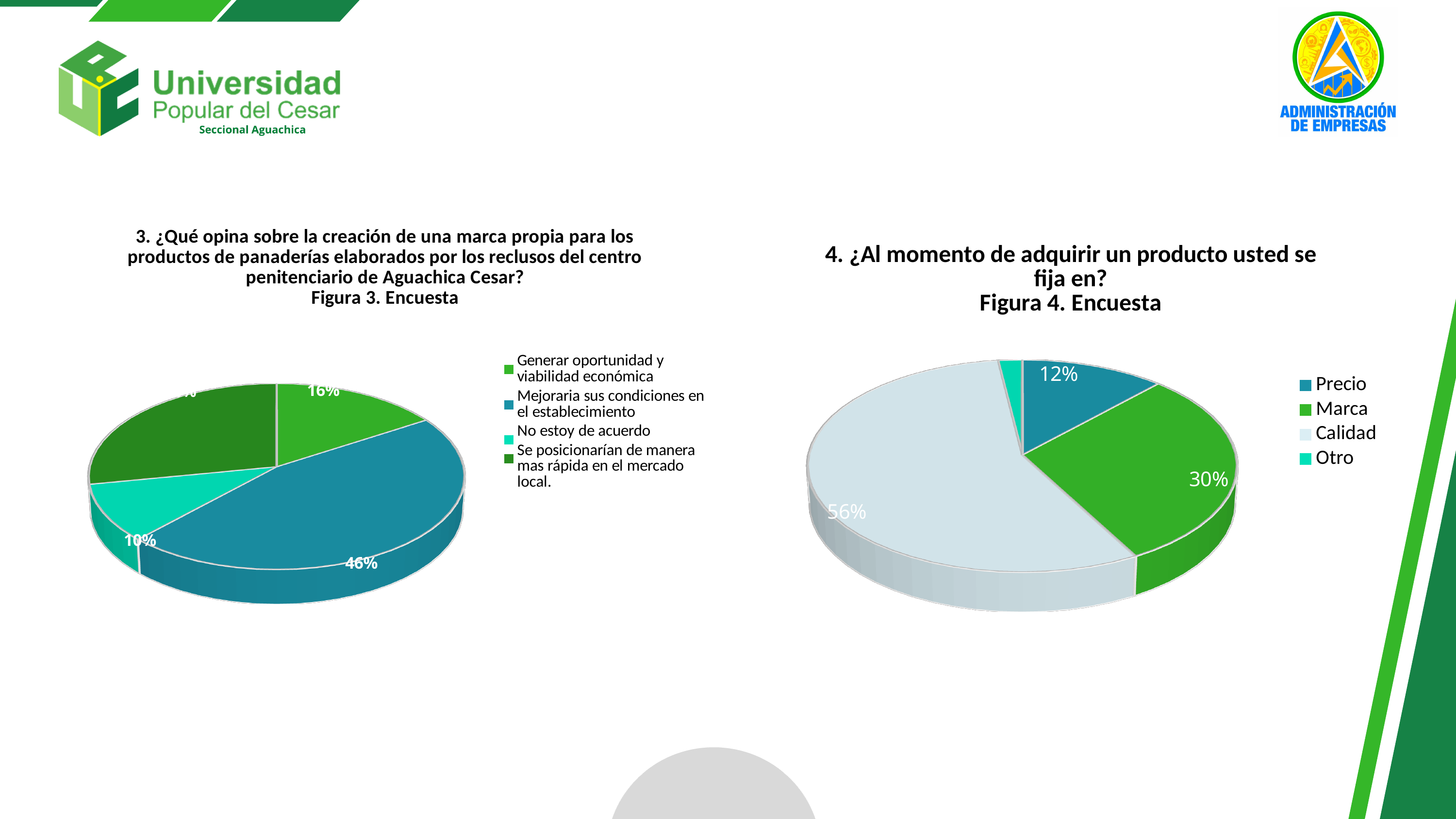
In the Figura 4 chart, which category has the smallest share? Otro In the Figura 4 chart, what percentage is shown for Marca? 30% In the Figura 3 chart, what percentage is shown for 'Generar oportunidad y viabilidad económica'? 16% In the Figura 4 chart, what percentage is shown for Precio? 12% In the Figura 3 chart, what percentage is shown for 'Mejoraria sus condiciones en el establecimiento'? 46% In the Figura 4 chart, how many categories does the legend list? 4 What type of chart is the Figura 3 chart? Pie chart In the Figura 3 chart, what percentage is shown for 'No estoy de acuerdo'? 10% In the Figura 4 chart, what is the difference in percentage points between Calidad and Marca? 26 In the Figura 3 chart, which is larger: 'Generar oportunidad y viabilidad económica' or 'No estoy de acuerdo'? Generar oportunidad y viabilidad económica In the Figura 4 chart, which category has the largest share? Calidad In the Figura 4 chart, what percentage is shown for Calidad? 56%